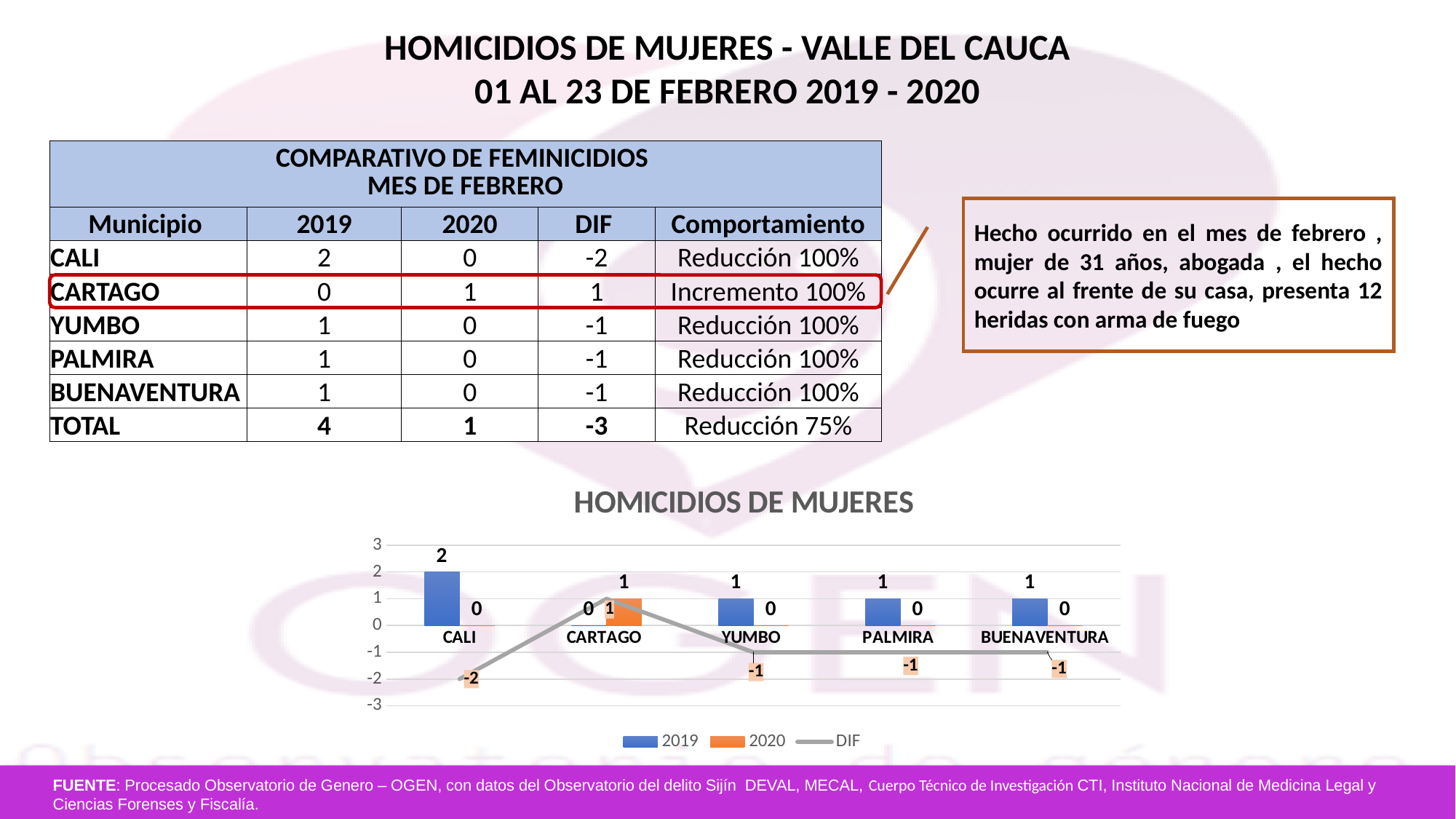
What is the DIF value for CALI in the HOMICIDIOS DE MUJERES chart? -2 How many municipalities are shown on the x axis of the HOMICIDIOS DE MUJERES chart? 5 What is the DIF value for YUMBO in the HOMICIDIOS DE MUJERES chart? -1 In the HOMICIDIOS DE MUJERES chart, which is larger: the 2019 value for CALI or the 2019 value for PALMIRA? 2019 value for CALI Which series in the HOMICIDIOS DE MUJERES chart is drawn as a line rather than bars? DIF What is the 2020 value for CARTAGO in the HOMICIDIOS DE MUJERES chart? 1 Which municipality has the lowest DIF value in the HOMICIDIOS DE MUJERES chart? CALI Which municipality has the lowest 2019 value in the HOMICIDIOS DE MUJERES chart? CARTAGO Which municipality has the highest 2019 value in the HOMICIDIOS DE MUJERES chart? CALI How many series does the legend of the HOMICIDIOS DE MUJERES chart list? 3 In the HOMICIDIOS DE MUJERES chart, what is the difference between the 2019 value for CALI and the 2019 value for YUMBO? 1 What is the 2019 value for CALI in the HOMICIDIOS DE MUJERES chart? 2